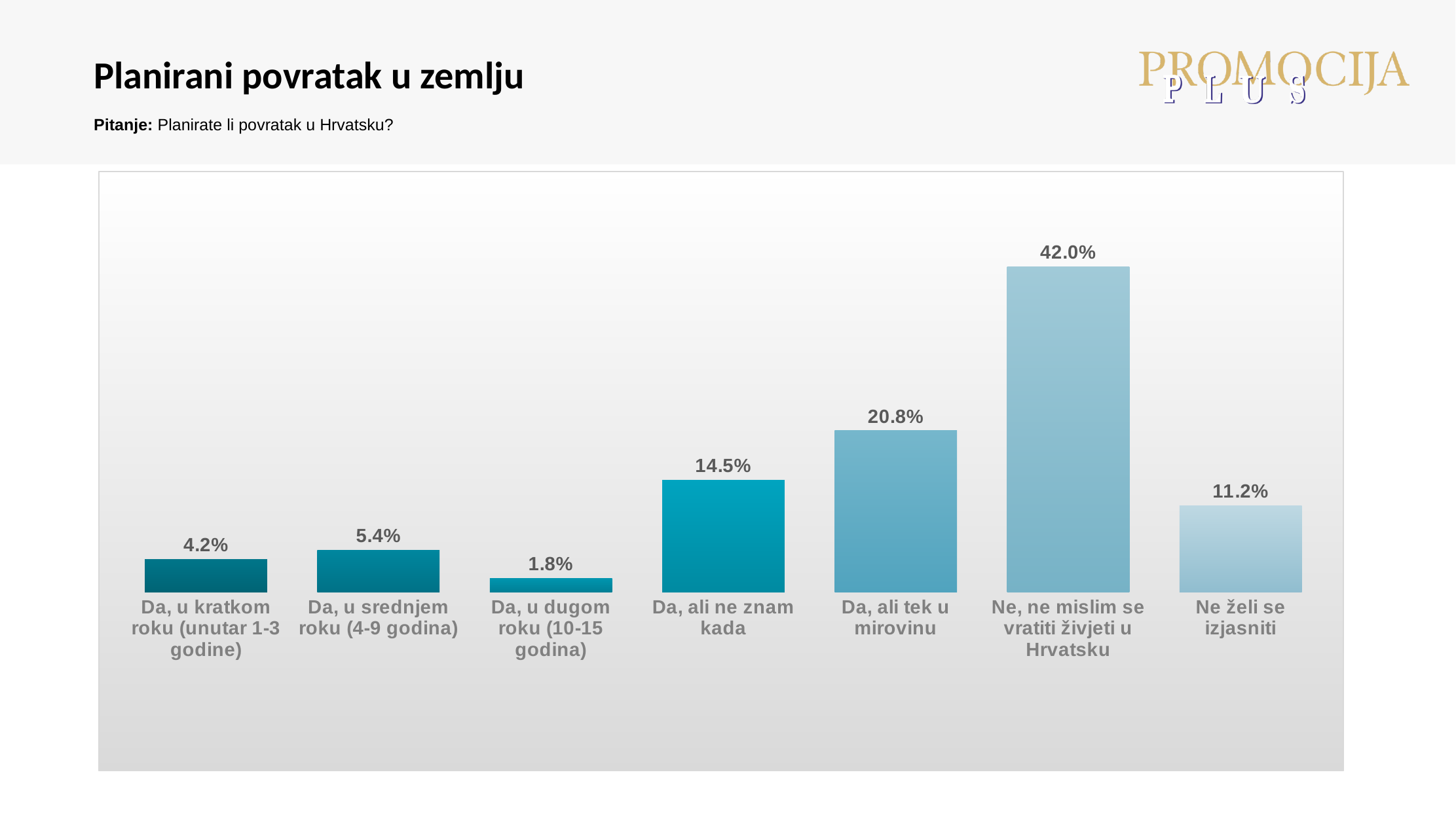
What is the value for "Da, ali tek u mirovinu"? 20.8% What question is the chart based on, as stated under the slide title? Planirate li povratak u Hrvatsku? What is the difference between "Ne, ne mislim se vratiti živjeti u Hrvatsku" and "Da, ali tek u mirovinu"? 21.2% What is the value for "Ne želi se izjasniti"? 11.2% What is the difference between "Da, u srednjem roku (4-9 godina)" and "Da, u kratkom roku (unutar 1-3 godine)"? 1.2% Which is larger, "Da, ali ne znam kada" or "Ne želi se izjasniti"? Da, ali ne znam kada Which category has the highest value? Ne, ne mislim se vratiti živjeti u Hrvatsku What kind of chart is shown on the slide? Bar chart How many categories are shown in the chart? 7 What is the value for "Ne, ne mislim se vratiti živjeti u Hrvatsku"? 42.0% Which category has the lowest value? Da, u dugom roku (10-15 godina) What is the value for "Da, u dugom roku (10-15 godina)"? 1.8%